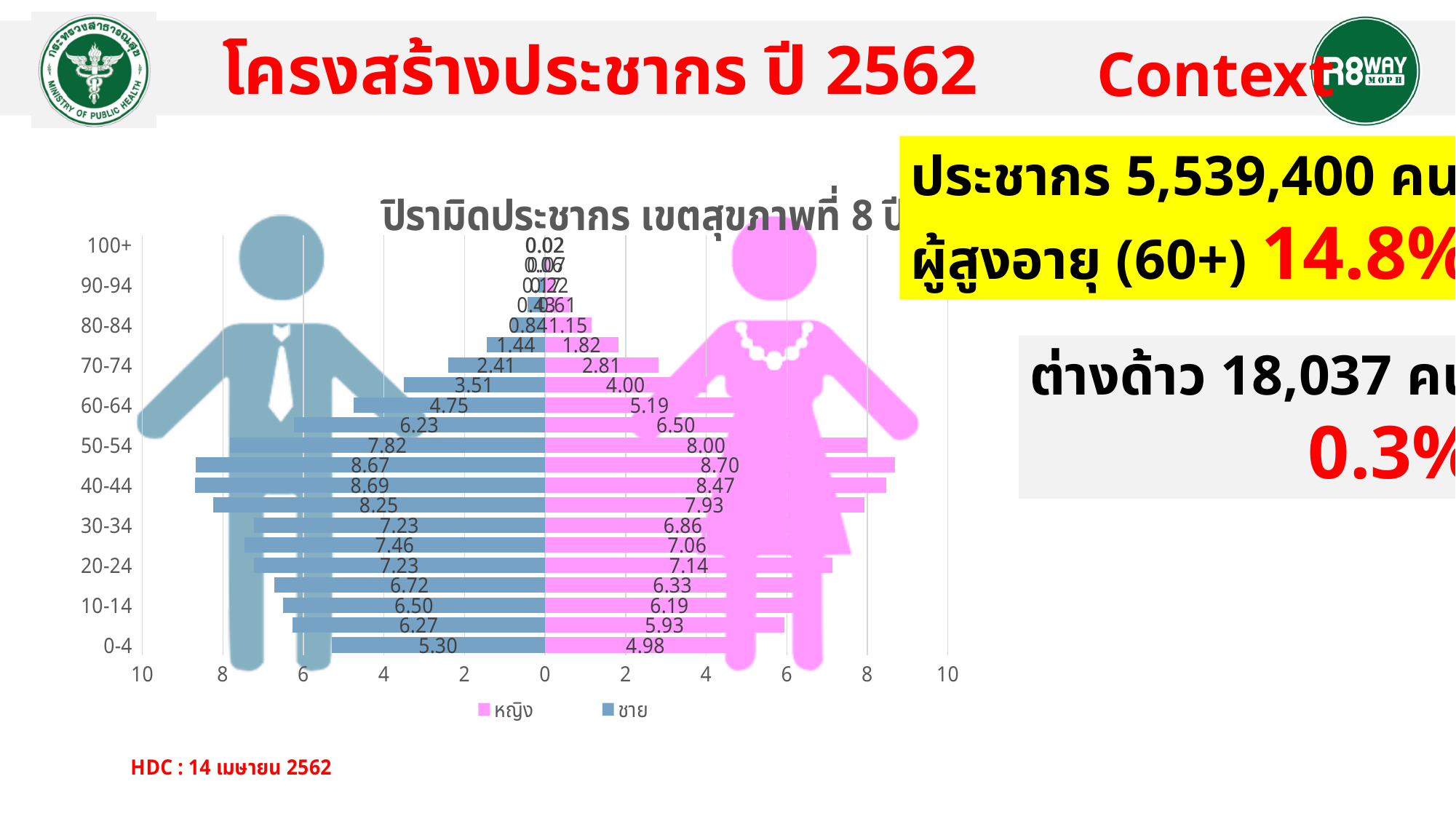
What kind of chart is the population pyramid? bar chart Is the value for males (ชาย) in the 30-34 age group greater or less than 6? greater What is the value for males (ชาย) in the 40-44 age group? 8.69 What is the value for females (หญิง) in the 0-4 age group? 4.98 In the 40-44 age group, how much larger is the male (ชาย) value than the female (หญิง) value? 0.22 What is the value for males (ชาย) in the 70-74 age group? 2.41 What is the value for females (หญิง) in the 60-64 age group? 5.19 In the 0-4 age group, which series has the larger value, males (ชาย) or females (หญิง)? males (ชาย) In the 60-64 age group, how much larger is the female (หญิง) value than the male (ชาย) value? 0.44 Is the value for females (หญิง) in the 80-84 age group greater or less than 2? less How many series does the legend of the population pyramid list? 2 In the 50-54 age group, which series has the larger value, males (ชาย) or females (หญิง)? females (หญิง)